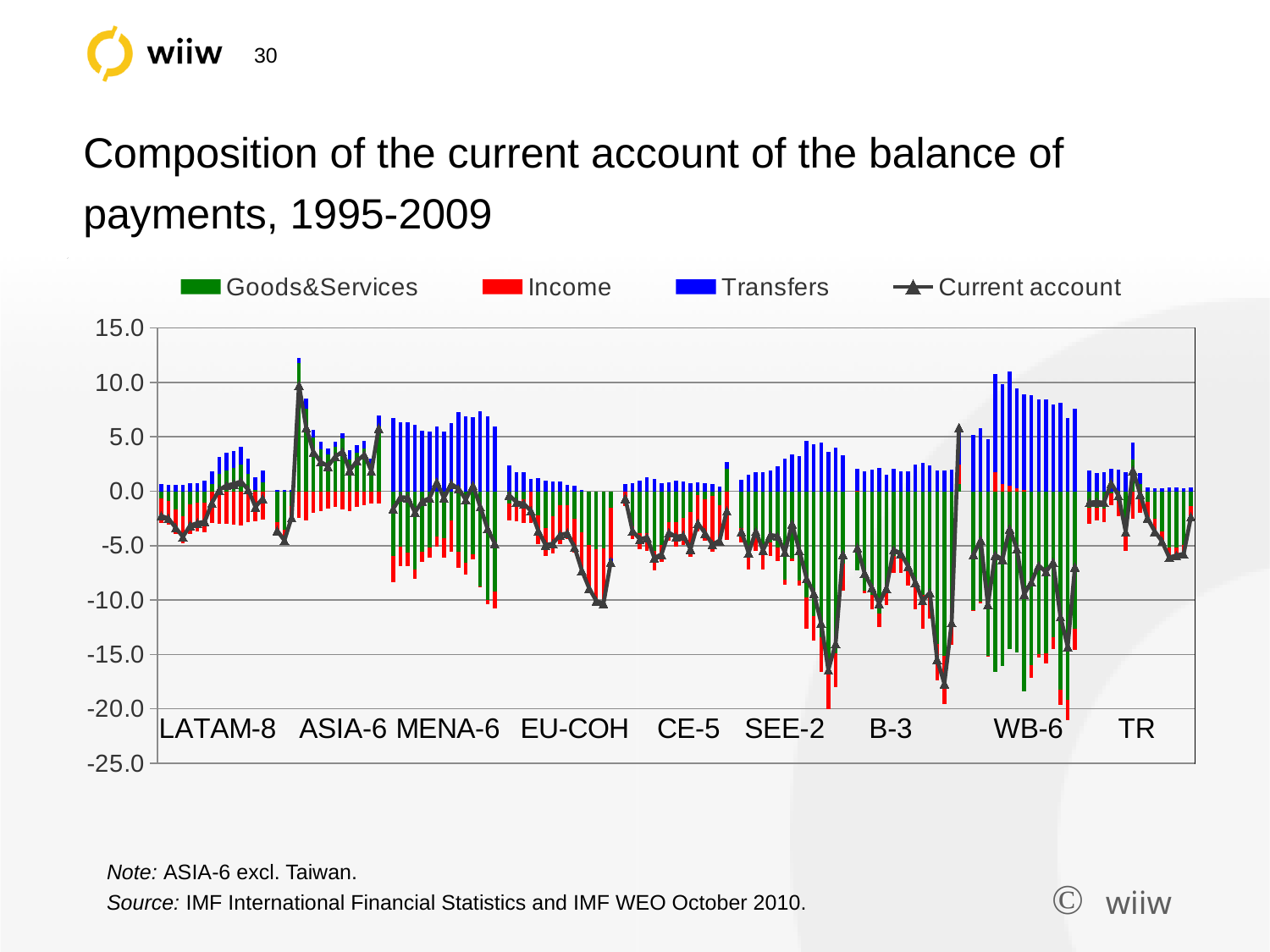
Is the lowest Current account point in the TR group greater or less than -10.0? greater How many region groups are labelled along the x axis? 9 Which region group contains the highest Current account point on the chart? ASIA-6 Is the highest Current account point in the LATAM-8 group greater or less than 5.0? less What is the title of the chart on the slide? Composition of the current account of the balance of payments, 1995-2009 Is the top of the tallest Transfers bar in the WB-6 group greater or less than 10.0? greater What kind of chart is shown on the slide? combination bar and line chart How many series does the legend list? 4 Which colour represents Transfers in the chart? blue